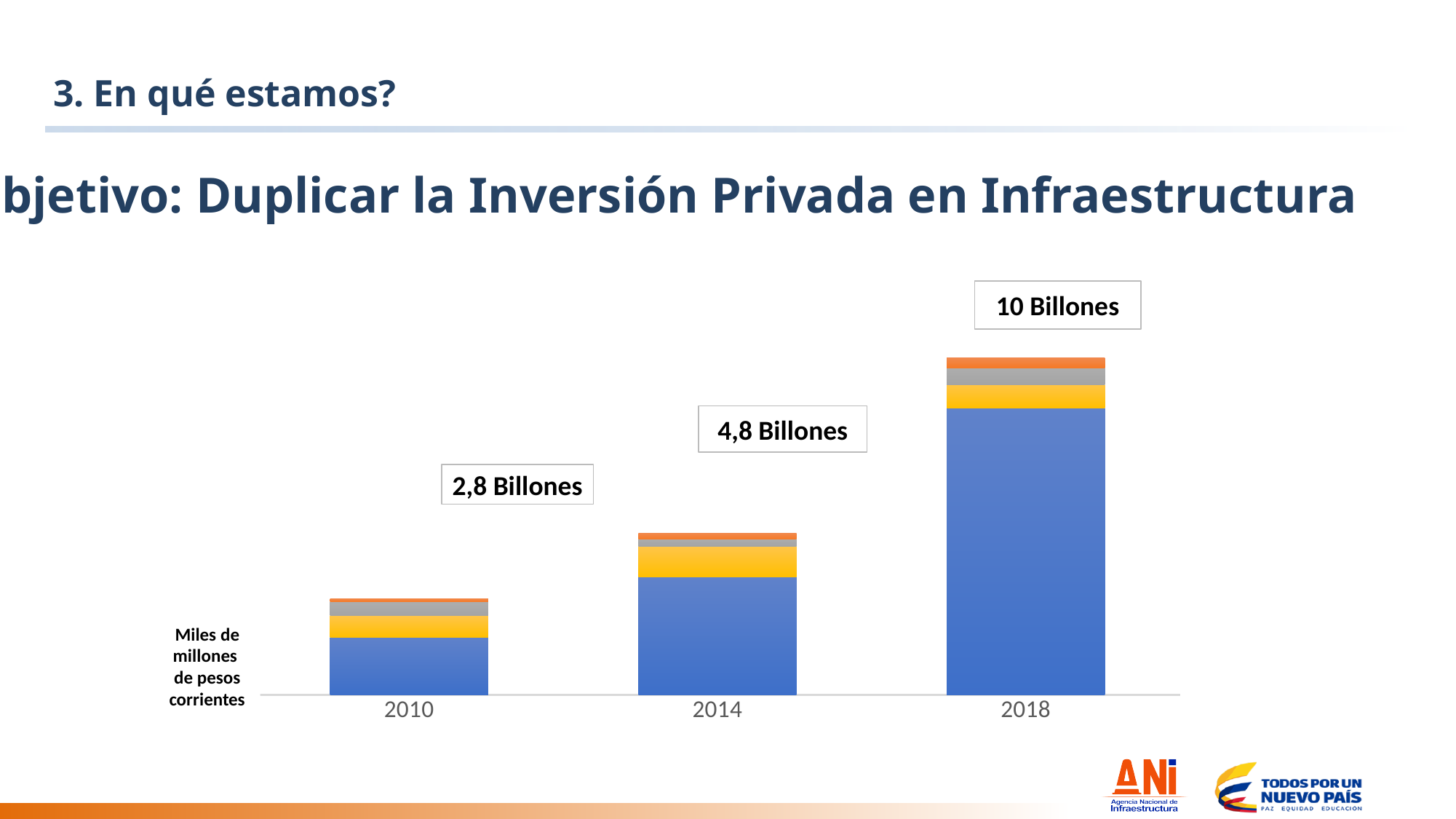
Do the total values rise or fall from 2010 to 2018? Rise What total value is labelled for the 2018 bar? 10 Billones Which is larger, the total for 2014 or the total for 2010? 2014 How many years are shown on the x axis? 3 What total value is labelled for the 2014 bar? 4,8 Billones What kind of chart is shown on the slide? Stacked bar chart What unit label is written next to the vertical axis of the chart? Miles de millones de pesos corrientes What is the difference between the 2014 total and the 2010 total? 2 Billones What is the difference between the 2018 total and the 2014 total? 5,2 Billones What total value is labelled for the 2010 bar? 2,8 Billones Which year has the lowest total investment? 2010 Which year has the highest total investment? 2018